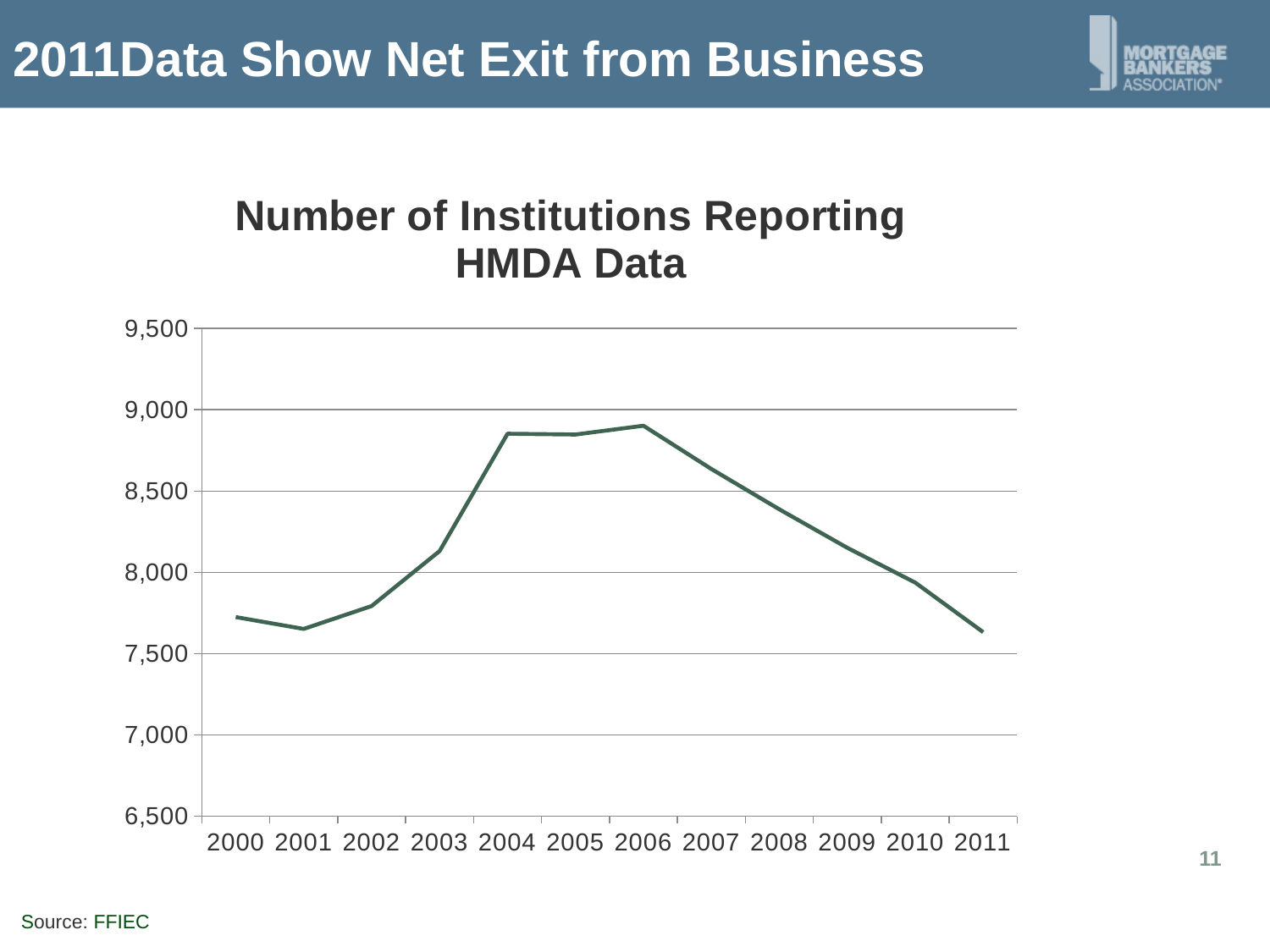
What source is cited for the chart data? FFIEC Is the value for 2008 greater or less than 8,000? greater Which year has the larger value, 2008 or 2011? 2008 Is the value for 2006 greater or less than 9,000? less How many years are plotted on the x axis of the chart? 12 What kind of chart is shown on the slide? Line chart Is the value for 2000 greater or less than 8,000? less Do the values rise or fall from 2006 to 2011? fall Which year has the larger value, 2004 or 2000? 2004 What is the title of the chart? Number of Institutions Reporting HMDA Data